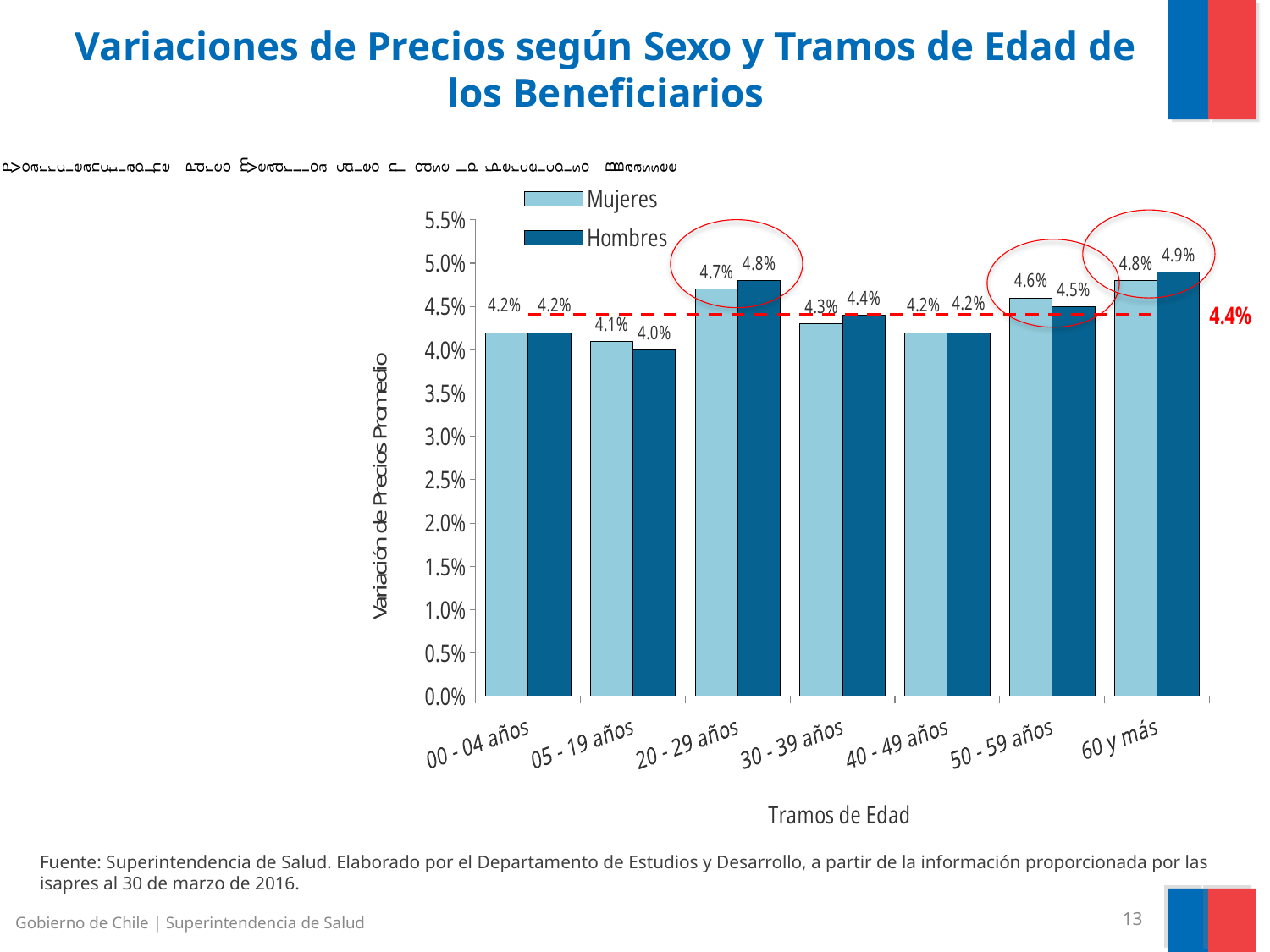
What is the value for Hombres in the 60 y más age group? 4.9% What is the difference between the Hombres and Mujeres values in the 30 - 39 años age group? 0.1% What is the value for Mujeres in the 20 - 29 años age group? 4.7% Which age group has the highest value for Hombres? 60 y más How many series does the legend list? 2 What value is marked by the red dashed horizontal line? 4.4% What is the value for Mujeres in the 50 - 59 años age group? 4.6% What is the value for Hombres in the 05 - 19 años age group? 4.0% How many age groups are shown on the x axis? 7 In the 50 - 59 años age group, which series has the larger value, Mujeres or Hombres? Mujeres What kind of chart is shown on the slide? Bar chart Which age group has the lowest value for Mujeres? 05 - 19 años